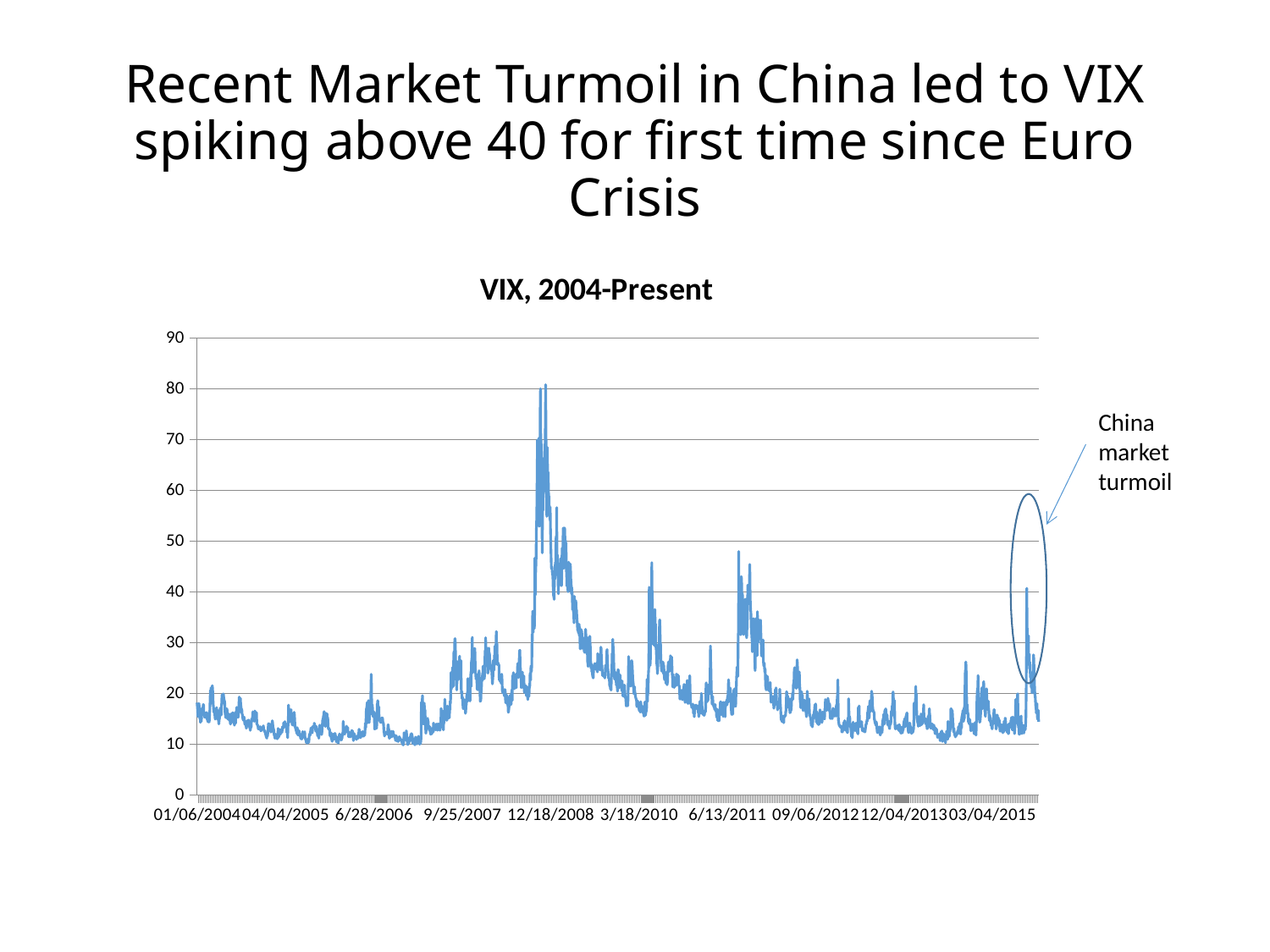
What text does the annotation next to the circled spike on the right of the chart say? China market turmoil Near which horizontal-axis date label does the VIX line reach its highest peak? 12/18/2008 How many lines are plotted on the chart? 1 What kind of chart is shown on the slide? line chart Is the circled China market turmoil spike greater or less than 30? greater What is the title of the chart? VIX, 2004-Present What is the last date label shown on the horizontal axis? 03/04/2015 What is the highest value shown on the vertical axis of the chart? 90 Is the highest peak of the VIX line greater or less than 70? greater What is the first date label shown on the horizontal axis? 01/06/2004 Which is higher: the peak near 12/18/2008 or the peak near 6/13/2011? the peak near 12/18/2008